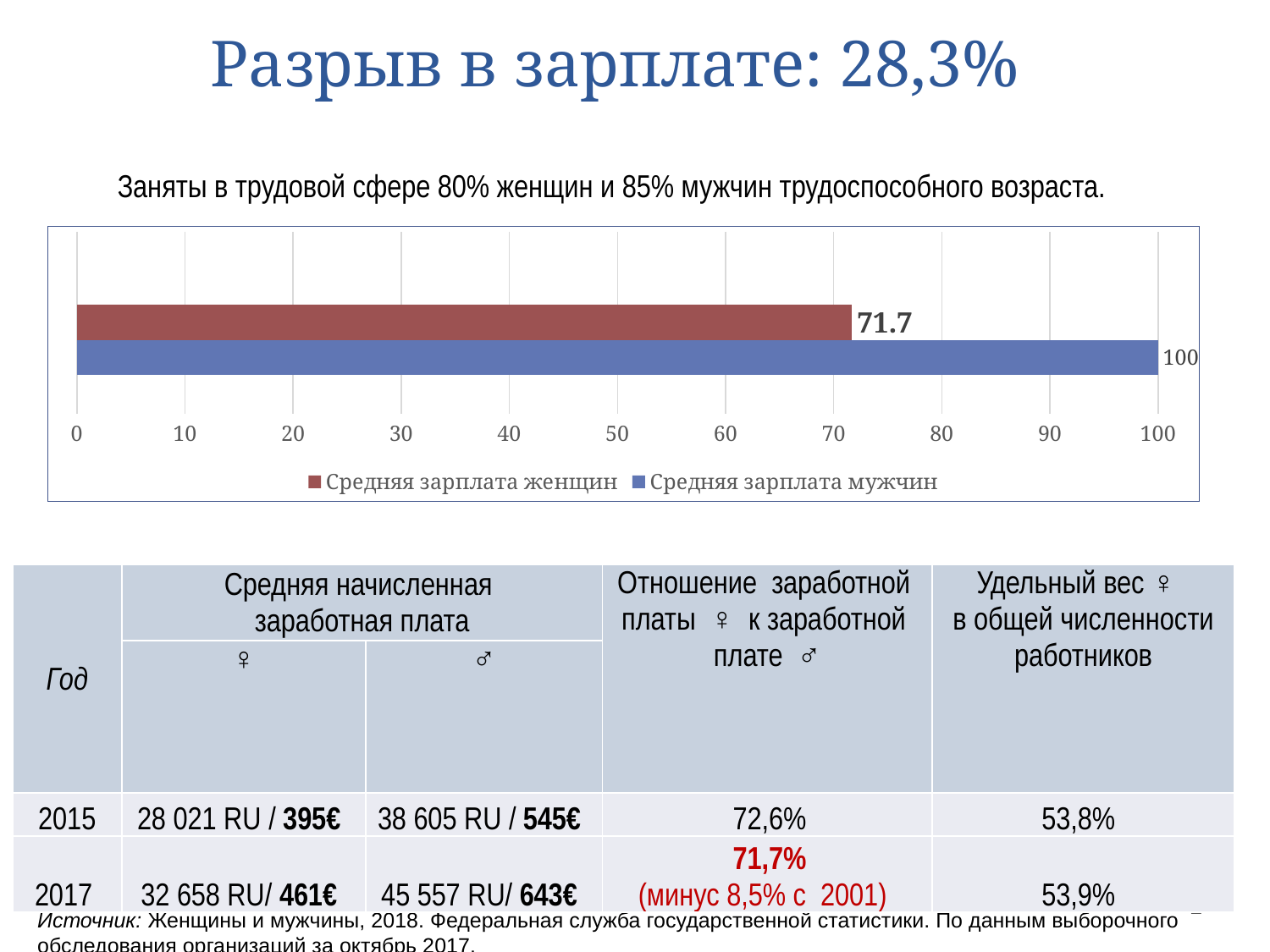
What is the value shown for Средняя зарплата женщин? 71.7 Which series has the higher value, Средняя зарплата женщин or Средняя зарплата мужчин? Средняя зарплата мужчин How many series does the chart legend list? 2 What is the difference between the value for Средняя зарплата мужчин and the value for Средняя зарплата женщин? 28.3 What kind of chart is shown on the slide? bar chart Is the value for Средняя зарплата женщин greater or less than 80? less Is the value for Средняя зарплата женщин greater or less than 70? greater What is the value shown for Средняя зарплата мужчин? 100 What colour is the bar for Средняя зарплата мужчин? blue What is the maximum value shown on the chart's horizontal axis? 100 Which series has the lowest value in the chart? Средняя зарплата женщин Which series has the highest value in the chart? Средняя зарплата мужчин